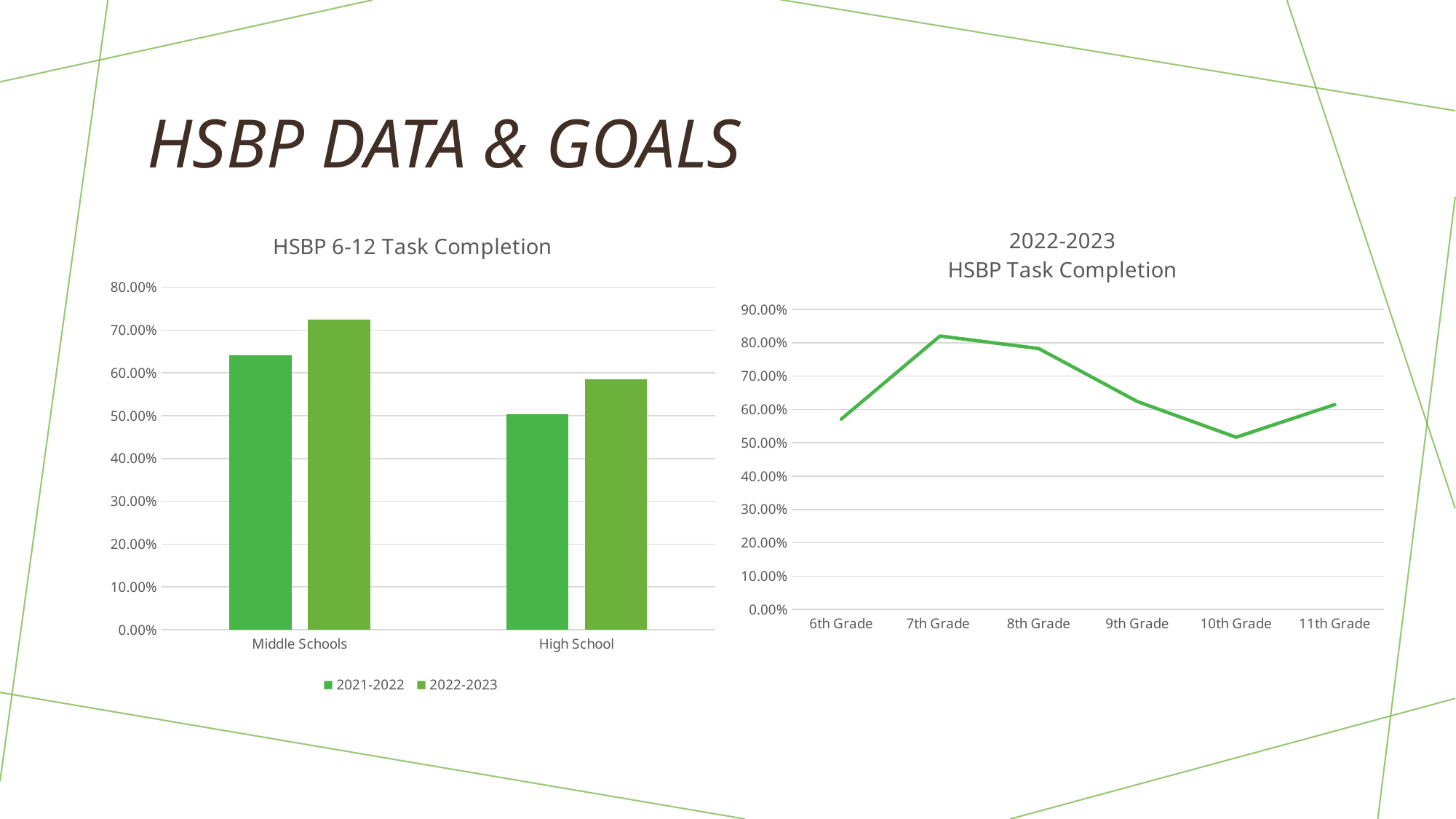
In the 'HSBP 6-12 Task Completion' chart, is the 2022-2023 value for Middle Schools greater or less than 70.00%? greater What type of chart is the 'HSBP 6-12 Task Completion' chart on the left? bar chart In the '2022-2023 HSBP Task Completion' chart, is the value for 7th Grade greater or less than 80.00%? greater In the '2022-2023 HSBP Task Completion' chart, which grade has the highest task completion? 7th Grade In the '2022-2023 HSBP Task Completion' chart, how many grade levels are plotted? 6 In the '2022-2023 HSBP Task Completion' chart, do the values rise or fall from 7th Grade to 10th Grade? fall In the '2022-2023 HSBP Task Completion' chart, which grade has the lowest task completion? 10th Grade In the 'HSBP 6-12 Task Completion' chart, how many series does the legend list? 2 In the 'HSBP 6-12 Task Completion' chart, which category has the higher 2022-2023 value, Middle Schools or High School? Middle Schools In the 'HSBP 6-12 Task Completion' chart, for Middle Schools, which series is larger, 2021-2022 or 2022-2023? 2022-2023 What type of chart is the '2022-2023 HSBP Task Completion' chart on the right? line chart In the 'HSBP 6-12 Task Completion' chart, is the 2021-2022 value for High School greater or less than 60.00%? less